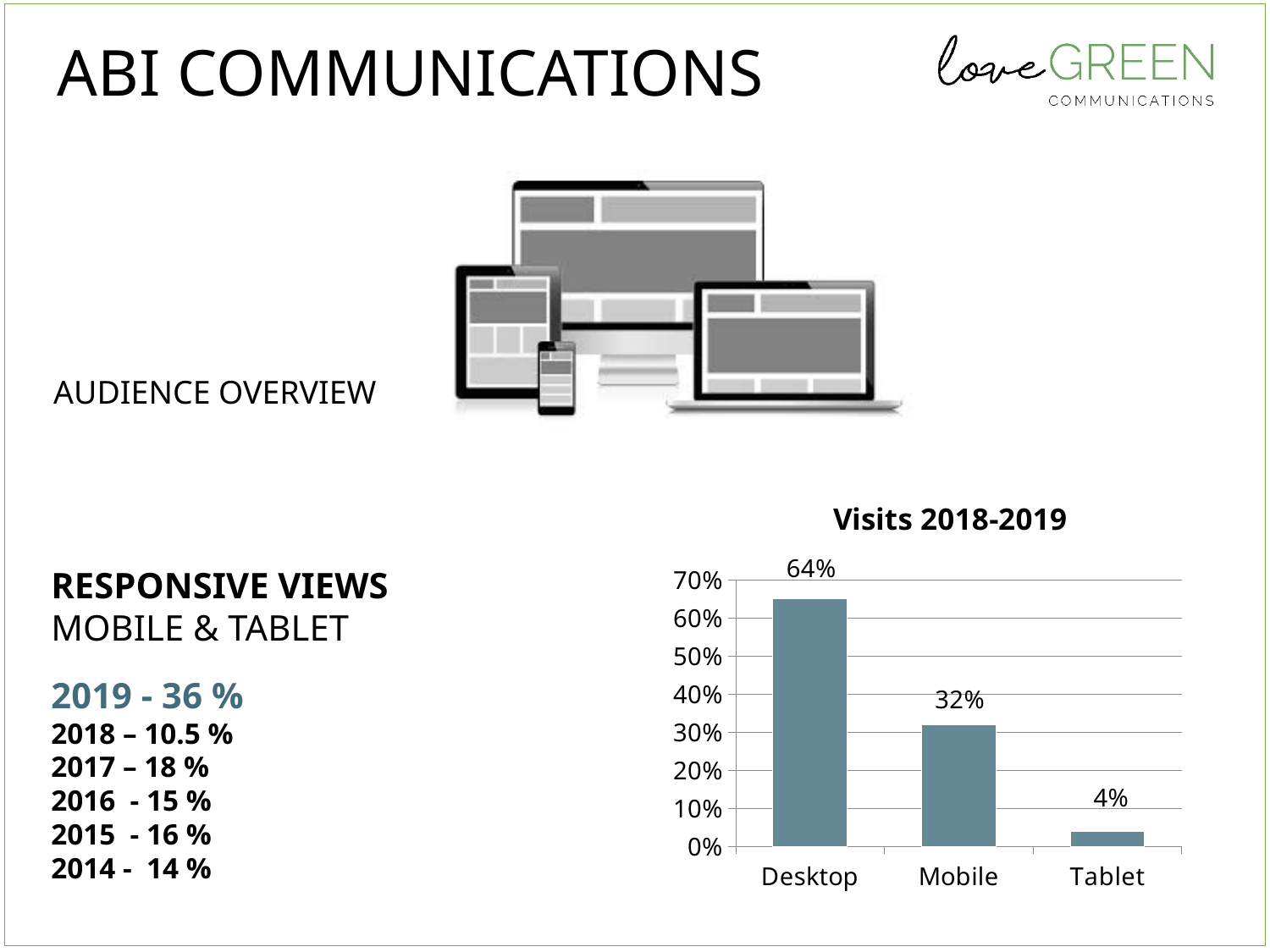
What kind of chart is the Visits 2018-2019 chart? bar chart Which category has the lowest value in the Visits 2018-2019 chart? Tablet What is the value for Desktop in the Visits 2018-2019 chart? 64% Which category has the highest value in the Visits 2018-2019 chart? Desktop Which is larger in the Visits 2018-2019 chart, Mobile or Tablet? Mobile What is the difference between the Desktop and Mobile values in the Visits 2018-2019 chart? 32% What is the value for Mobile in the Visits 2018-2019 chart? 32% Is the value for Desktop greater or less than 50% in the Visits 2018-2019 chart? greater What is the value for Tablet in the Visits 2018-2019 chart? 4% What is the title of the chart on the slide? Visits 2018-2019 How many categories are shown in the Visits 2018-2019 chart? 3 What is the difference between the Mobile and Tablet values in the Visits 2018-2019 chart? 28%